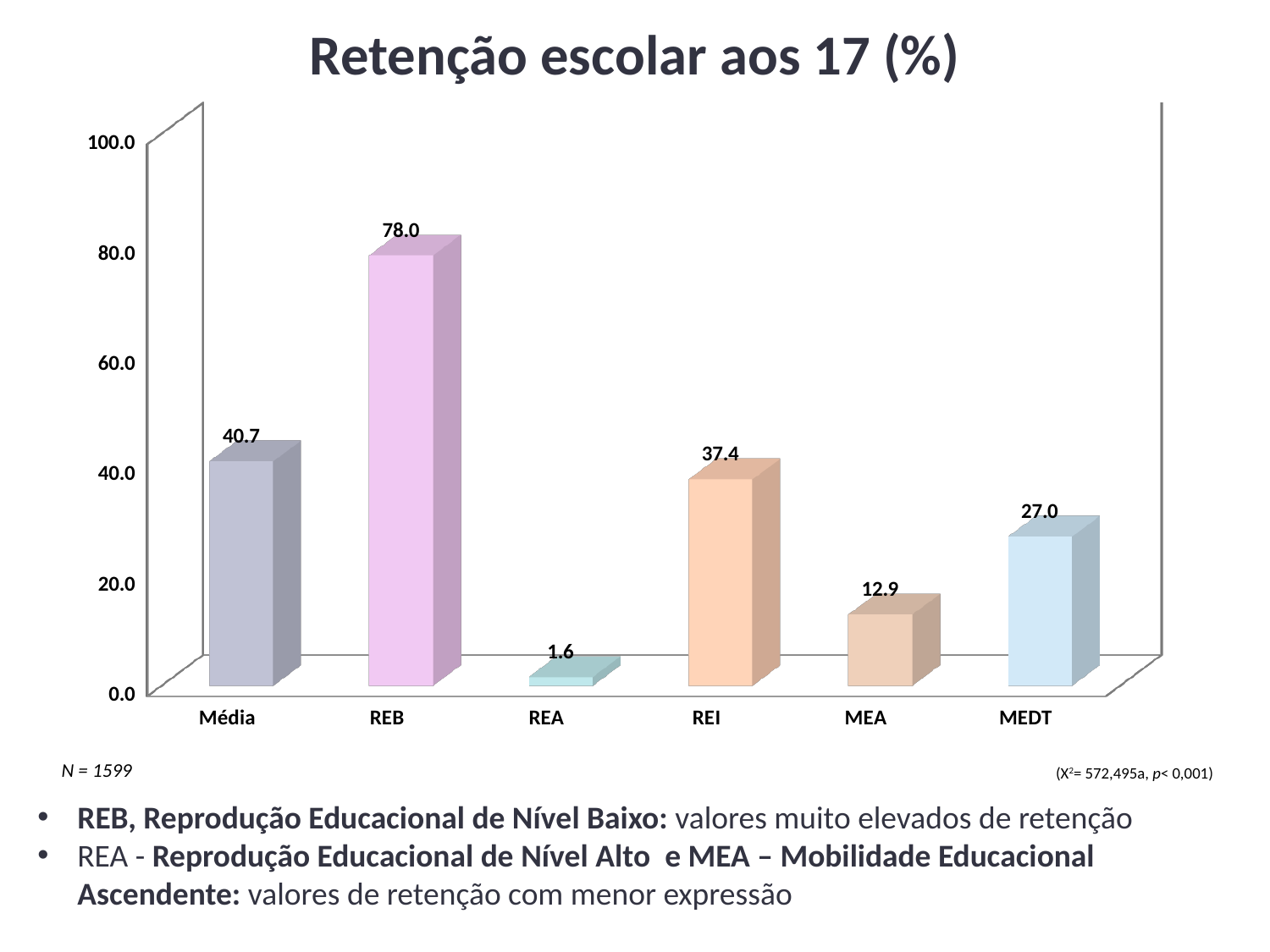
Which category has the lowest value? REA What is the difference between the values for MEDT and MEA? 14.1 What is the value for MEDT? 27.0 What is the difference between the values for REB and REI? 40.6 Is the value for REI greater or less than 20.0? greater What is the title of the chart? Retenção escolar aos 17 (%) How many categories are shown on the x axis? 6 What is the value for Média? 40.7 Which is larger, the value for Média or the value for REI? Média What is the value for REB? 78.0 Which category has the highest value? REB What kind of chart is shown on the slide? bar chart